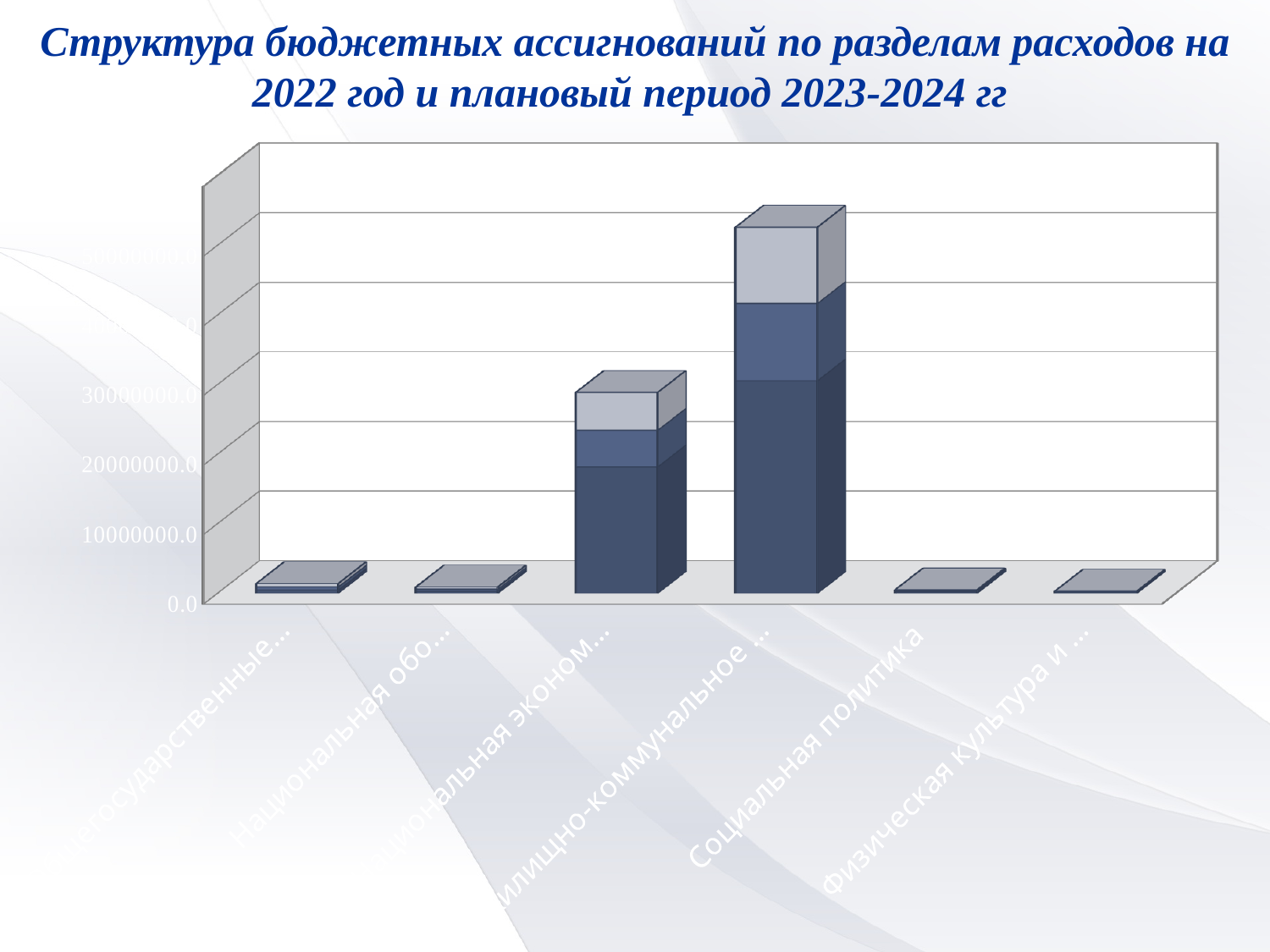
How many stacked segments make up each of the two tall bars? 3 How many categories are shown along the x axis of the chart? 6 What is the title of the slide containing the chart? Структура бюджетных ассигнований по разделам расходов на 2022 год и плановый период 2023-2024 гг Which has the larger stacked bar: Жилищно-коммунальное ... or Национальная эконом...? Жилищно-коммунальное ... Is the total stacked bar for Социальная политика greater or less than 10000000.0? less Is the total stacked bar for Общегосударственные... greater or less than 10000000.0? less What kind of chart is shown on the slide? Stacked bar chart Is the bottom (darkest) segment of the Жилищно-коммунальное ... bar greater or less than 20000000.0? greater Which has the larger stacked bar: Национальная эконом... or Физическая культура и ...? Национальная эконом... Which category has the tallest stacked bar? Жилищно-коммунальное ...